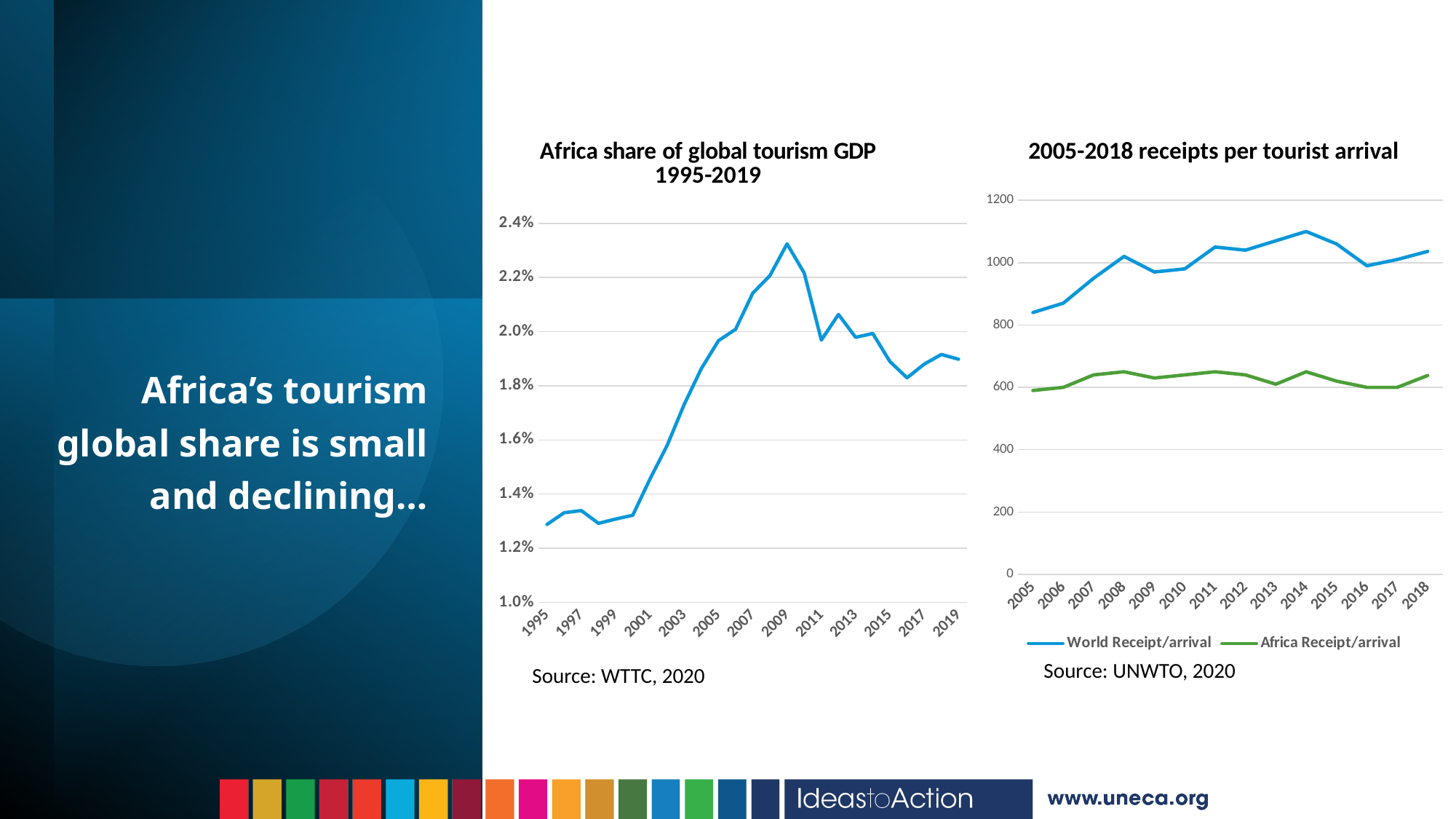
In the '2005-2018 receipts per tourist arrival' chart, is the World Receipt/arrival value for 2014 greater or less than 1000? greater In the '2005-2018 receipts per tourist arrival' chart, how many years are shown on the x axis? 14 In the 'Africa share of global tourism GDP 1995-2019' chart, is the value for 2009 greater or less than 2.2%? greater In the 'Africa share of global tourism GDP 1995-2019' chart, in which year does the share reach its highest point? 2009 In the 'Africa share of global tourism GDP 1995-2019' chart, does the share rise or fall between 2001 and 2009? rise In the 'Africa share of global tourism GDP 1995-2019' chart, does the share rise or fall between 2009 and 2019? fall How many series does the legend of the '2005-2018 receipts per tourist arrival' chart list? 2 What kind of chart is the 'Africa share of global tourism GDP 1995-2019' chart? line chart In the '2005-2018 receipts per tourist arrival' chart, what colour is the Africa Receipt/arrival line? green In the 'Africa share of global tourism GDP 1995-2019' chart, is the value for 1995 greater or less than 1.4%? less In the '2005-2018 receipts per tourist arrival' chart, in which year does World Receipt/arrival reach its highest point? 2014 In the '2005-2018 receipts per tourist arrival' chart, which series is higher in 2018, World Receipt/arrival or Africa Receipt/arrival? World Receipt/arrival